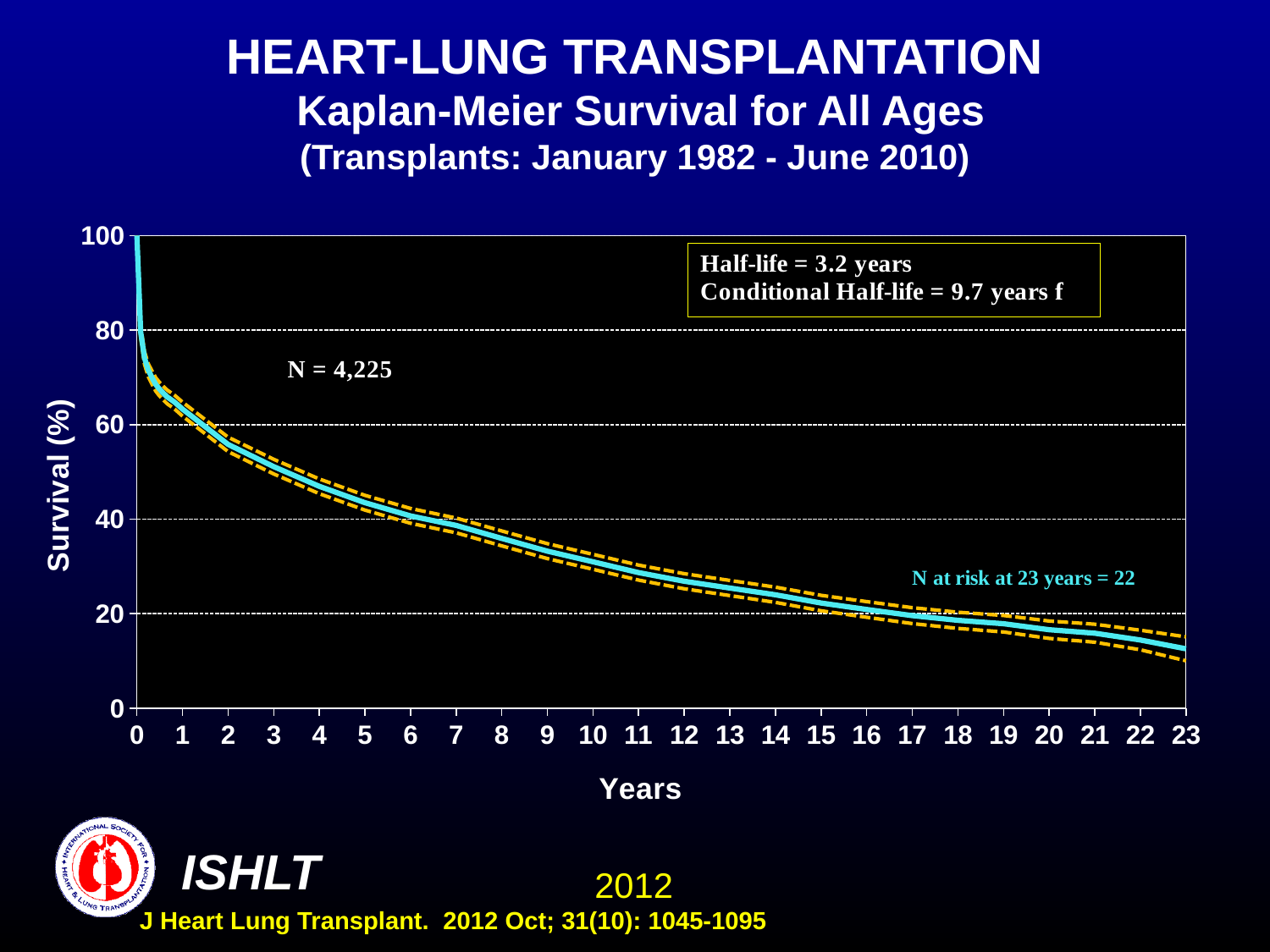
What is the value of N shown on the chart? 4,225 Does survival rise or fall as years since transplant increase? fall Is the survival value at 1 year greater or less than 60? greater What is the number at risk at 23 years? 22 What is the half-life reported on the chart? 3.2 years Is the survival value at 10 years greater or less than 40? less Is the survival value at 20 years greater or less than 20? less What is the highest year shown on the x axis? 23 What is the label of the y axis? Survival (%) What kind of chart is shown on the slide? line chart What is the conditional half-life reported on the chart? 9.7 years